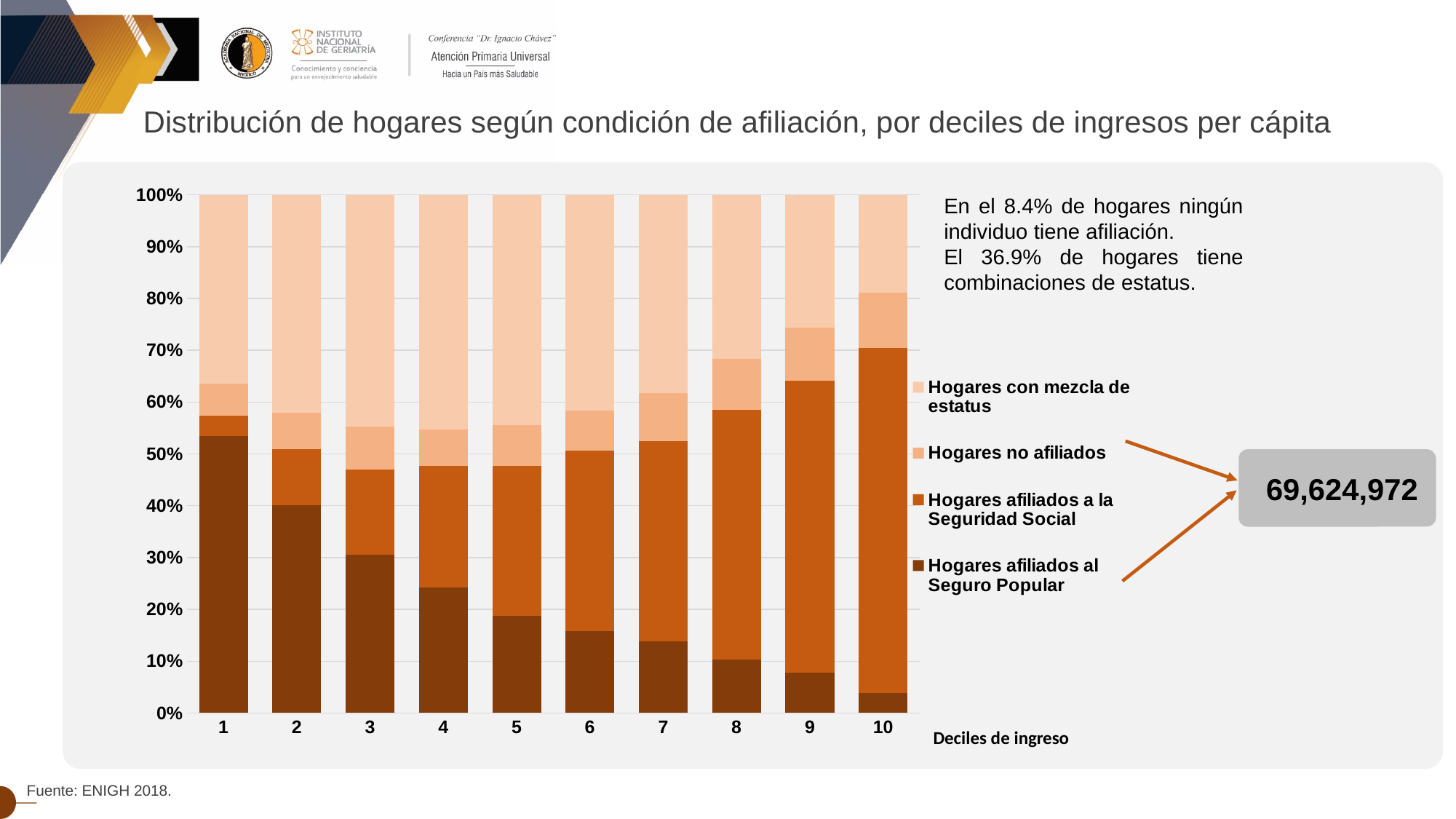
How many income deciles are shown on the x axis of the chart? 10 Does the share of 'Hogares afiliados al Seguro Popular' rise or fall as the income decile increases from 1 to 10? Fall In which decile is the share of 'Hogares afiliados al Seguro Popular' highest? 1 How many series does the chart legend list? 4 What kind of chart is shown on the slide? Stacked bar chart Does the share of 'Hogares afiliados a la Seguridad Social' rise or fall as the income decile increases from 1 to 10? Rise Is the share of 'Hogares afiliados al Seguro Popular' in decile 10 greater or less than 10%? less In which decile is the share of 'Hogares afiliados al Seguro Popular' lowest? 10 What is the label of the x axis of the chart? Deciles de ingreso Is the share of 'Hogares afiliados al Seguro Popular' in decile 1 greater or less than 50%? greater Which decile has a larger share of 'Hogares afiliados al Seguro Popular', decile 1 or decile 5? Decile 1 In which decile is the share of 'Hogares afiliados a la Seguridad Social' highest? 10